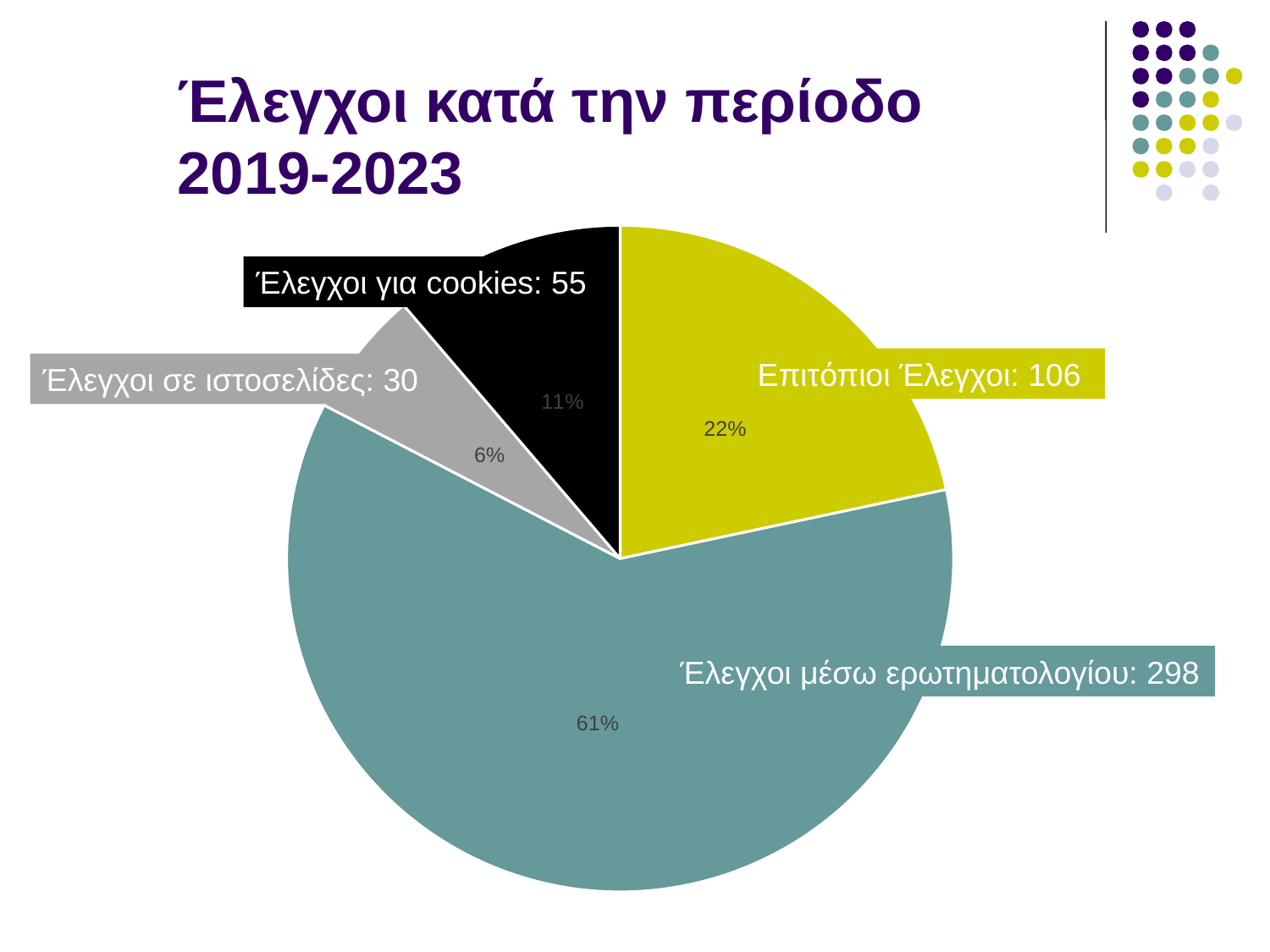
Which is larger, the value for Έλεγχοι για cookies or the value for Έλεγχοι σε ιστοσελίδες? Έλεγχοι για cookies What is the value for Έλεγχοι για cookies? 55 What is the value for Έλεγχοι μέσω ερωτηματολογίου? 298 What kind of chart is shown on the slide? pie chart How many slices does the pie chart have? 4 What is the difference between the values for Επιτόπιοι Έλεγχοι and Έλεγχοι για cookies? 51 Which category has the largest slice of the pie? Έλεγχοι μέσω ερωτηματολογίου What share of the pie does Έλεγχοι για cookies represent? 11% Which category has the smallest slice of the pie? Έλεγχοι σε ιστοσελίδες What is the value for Έλεγχοι σε ιστοσελίδες? 30 What is the value for Επιτόπιοι Έλεγχοι? 106 What share of the pie does Έλεγχοι μέσω ερωτηματολογίου represent? 61%